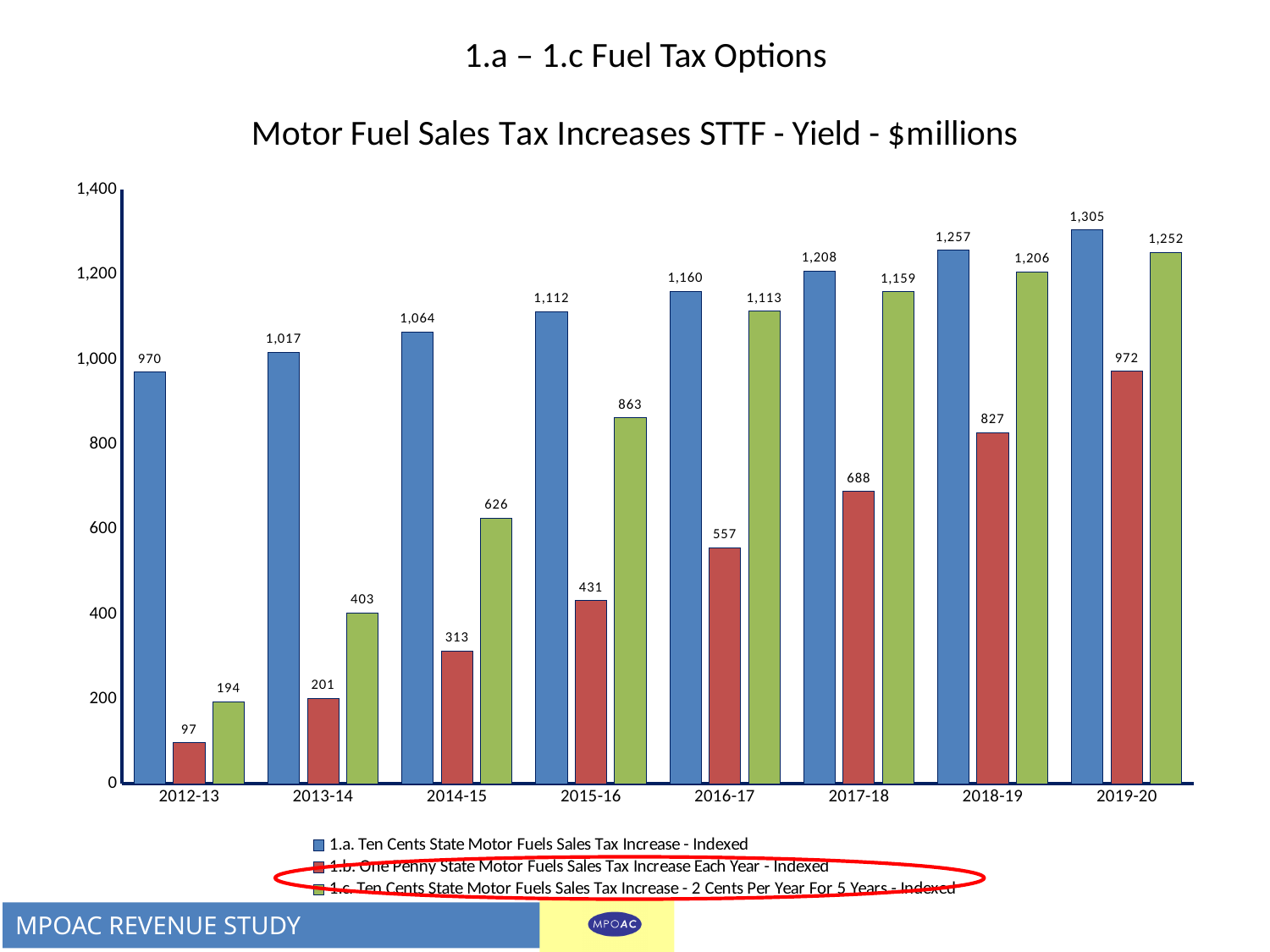
What is the value for series 1.a (Ten Cents State Motor Fuels Sales Tax Increase - Indexed) in 2012-13? 970 Is the value for series 1.b in 2018-19 greater or less than 800? greater Which is larger in 2016-17: the value for series 1.b or the value for series 1.c? 1.c What is the value for series 1.b (One Penny State Motor Fuels Sales Tax Increase Each Year - Indexed) in 2015-16? 431 What is the value for series 1.c (Ten Cents State Motor Fuels Sales Tax Increase - 2 Cents Per Year For 5 Years - Indexed) in 2017-18? 1,159 In which year is the value for series 1.a highest? 2019-20 What is the difference between the 1.a value and the 1.c value in 2019-20? 53 In which year is the value for series 1.b lowest? 2012-13 How many series does the legend list? 3 How many fiscal years are shown on the x axis? 8 What kind of chart is shown on the slide? Bar chart Do the values for series 1.b rise or fall from 2012-13 to 2019-20? Rise